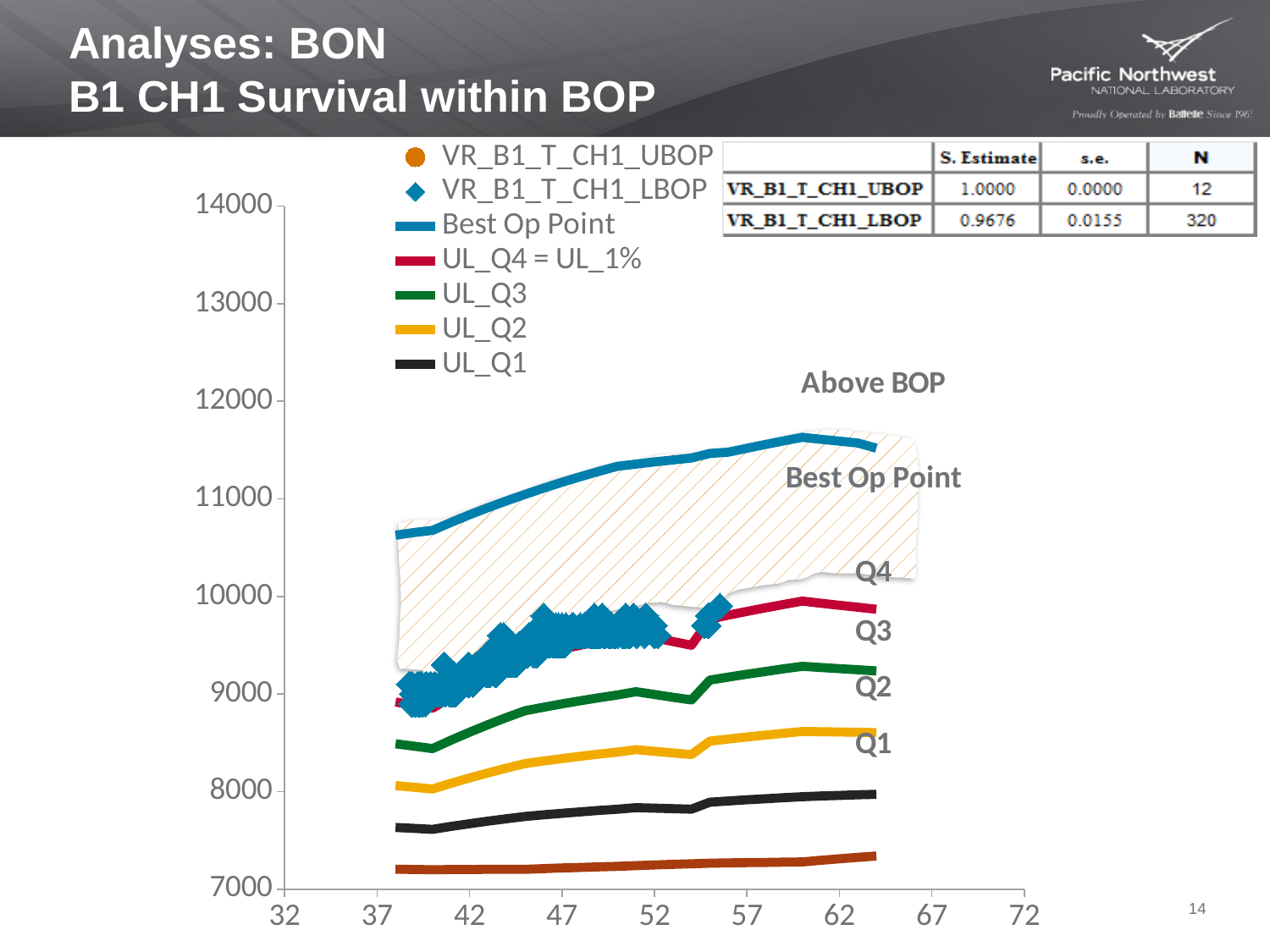
Is the value of the UL_Q2 line at x = 62 greater or less than 8000? greater Does the UL_Q1 line rise or fall overall from x = 38 to x = 63? rise Which series is plotted highest on the chart? Best Op Point Does the Best Op Point line rise or fall as the x axis goes from 38 to 63? rise Is the value of the Best Op Point line at x = 62 greater or less than 11000? greater Is the value of the UL_Q3 line at x = 62 greater or less than 9000? greater At x = 57, which is larger: the UL_Q3 line or the UL_Q2 line? UL_Q3 How many series does the chart legend list? 7 How many tick labels are shown on the x axis? 9 What kind of chart is shown on the slide? line chart Which legend entry corresponds to the red line? UL_Q4 = UL_1%